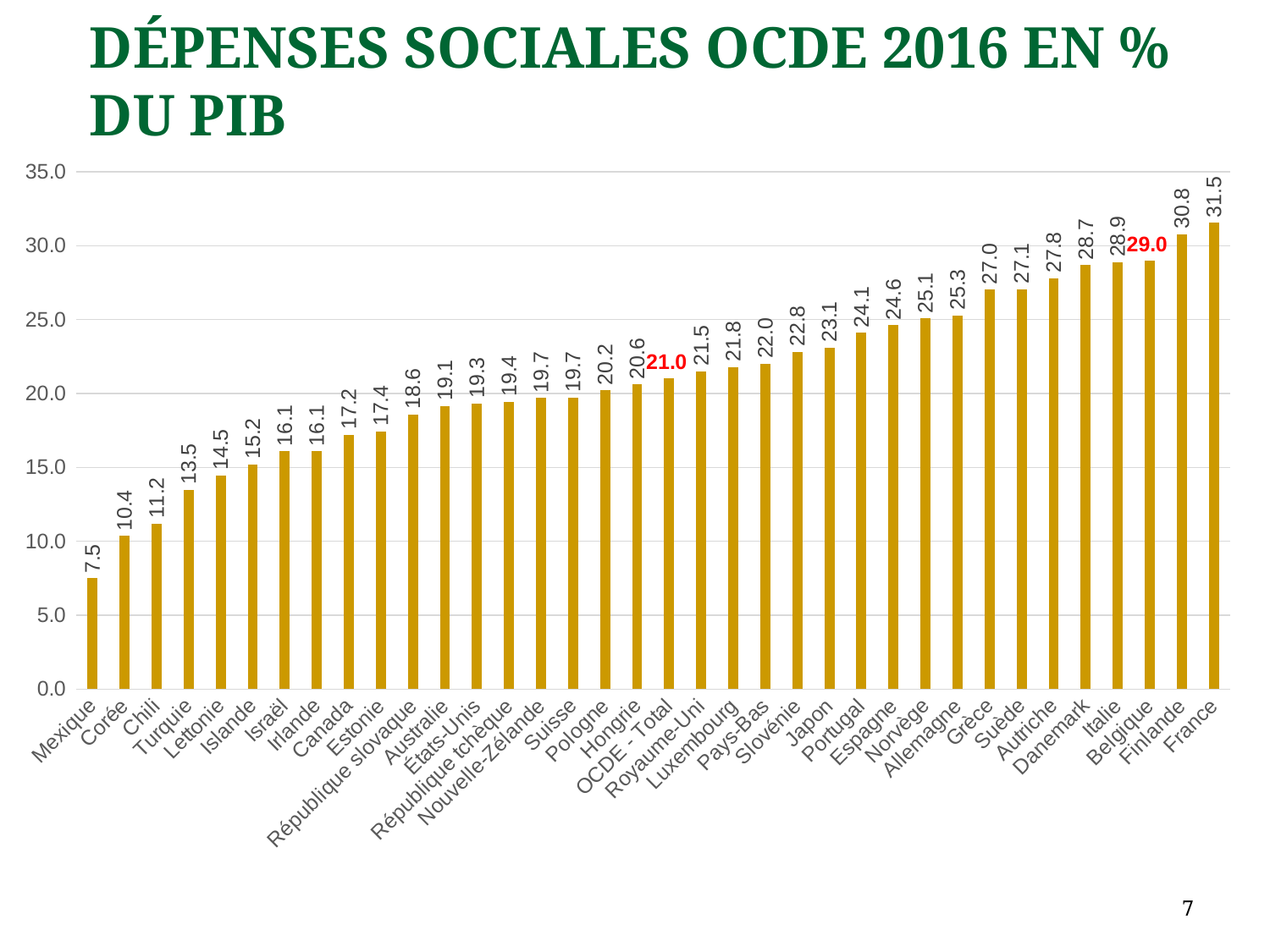
How many bars are shown in the chart? 36 What is the value for Allemagne? 25.3 Which country has the lowest value? Mexique Which country has the highest value? France What is the difference between the values for France and Mexique? 24.0 Which is larger, the value for Japon or the value for Canada? Japon What is the value for OCDE - Total? 21.0 What is the value for Belgique? 29.0 What is the value for France? 31.5 What is the difference between the values for Belgique and OCDE - Total? 8.0 What kind of chart is shown on the slide? Bar chart Do the values rise or fall from left to right along the x axis? Rise